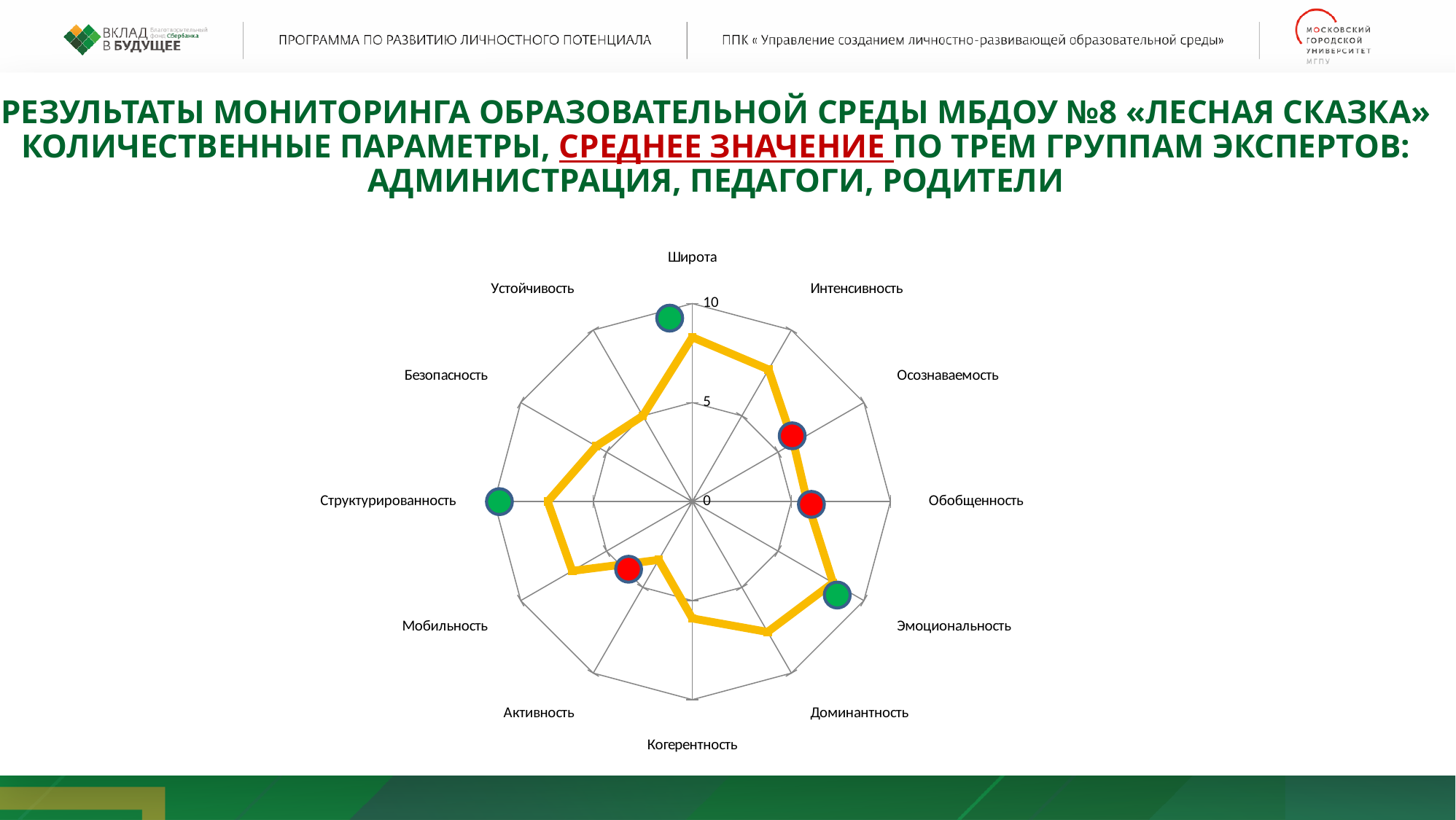
Which has the larger value, Интенсивность or Осознаваемость? Интенсивность Which has the larger value, Широта or Активность? Широта What colour is the data line on the radar chart? Yellow What kind of chart is shown on the slide? Radar chart Is the value for Широта greater or less than 5? greater What is the maximum value shown on the radar chart's axis scale? 10 Is the value for Структурированность greater or less than 5? greater Which category has the lowest value on the radar chart? Активность Is the value for Активность greater or less than 5? less How many categories (axes) does the radar chart have? 12